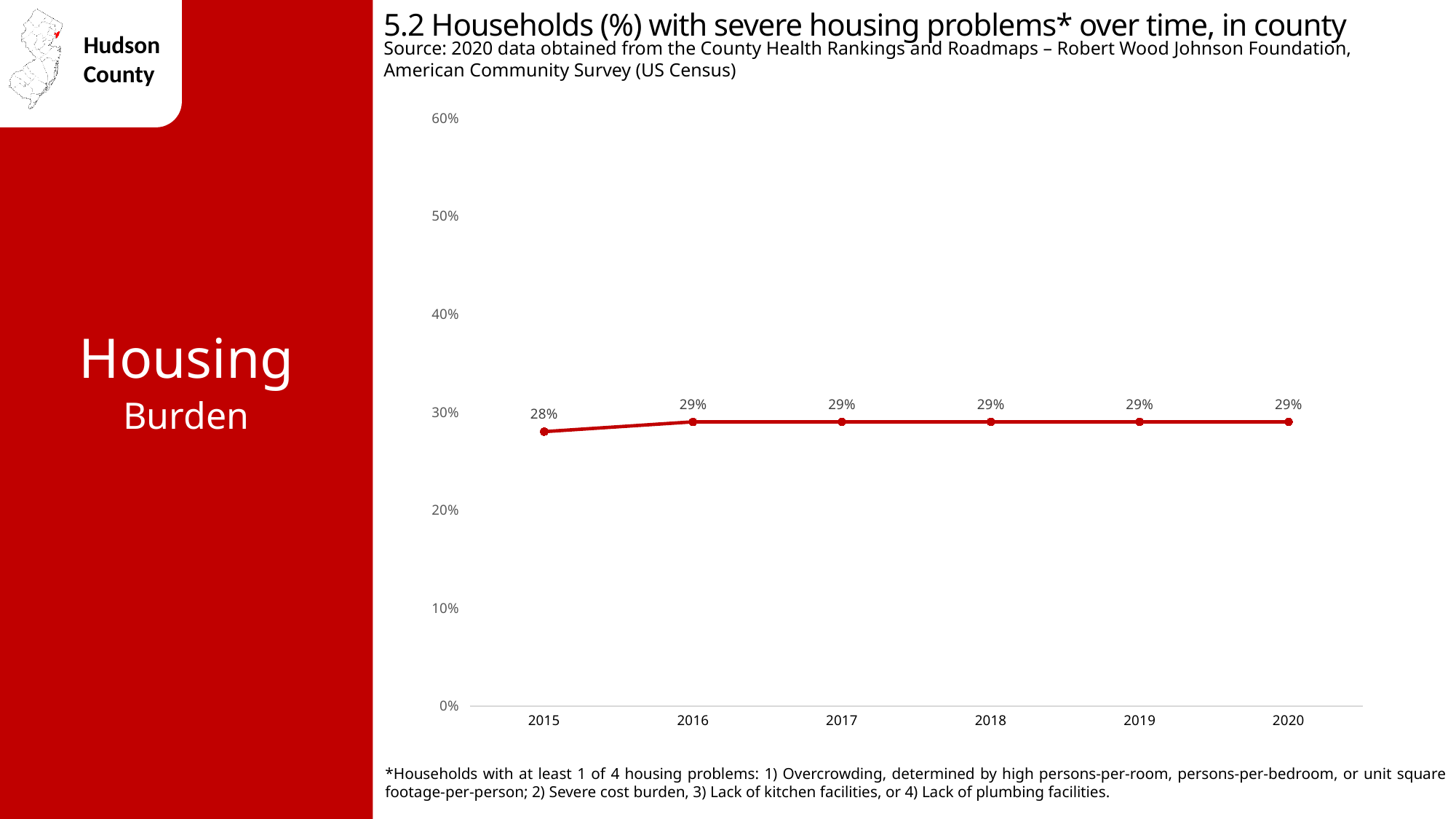
Is the value for 2019 greater or less than 40%? less What percentage of households had severe housing problems in 2015? 28% Which is larger, the value for 2015 or the value for 2017? 2017 What is the value shown for 2018? 29% What percentage of households had severe housing problems in 2020? 29% How many years are plotted on the chart? 6 What is the difference between the 2016 value and the 2015 value? 1% Is the value for 2015 greater or less than 20%? greater What kind of chart is shown on the slide? line chart Which year has the lowest percentage of households with severe housing problems? 2015 Does the percentage of households with severe housing problems rise, fall, or stay flat from 2016 to 2020? stays flat What is the title of the chart? 5.2 Households (%) with severe housing problems* over time, in county